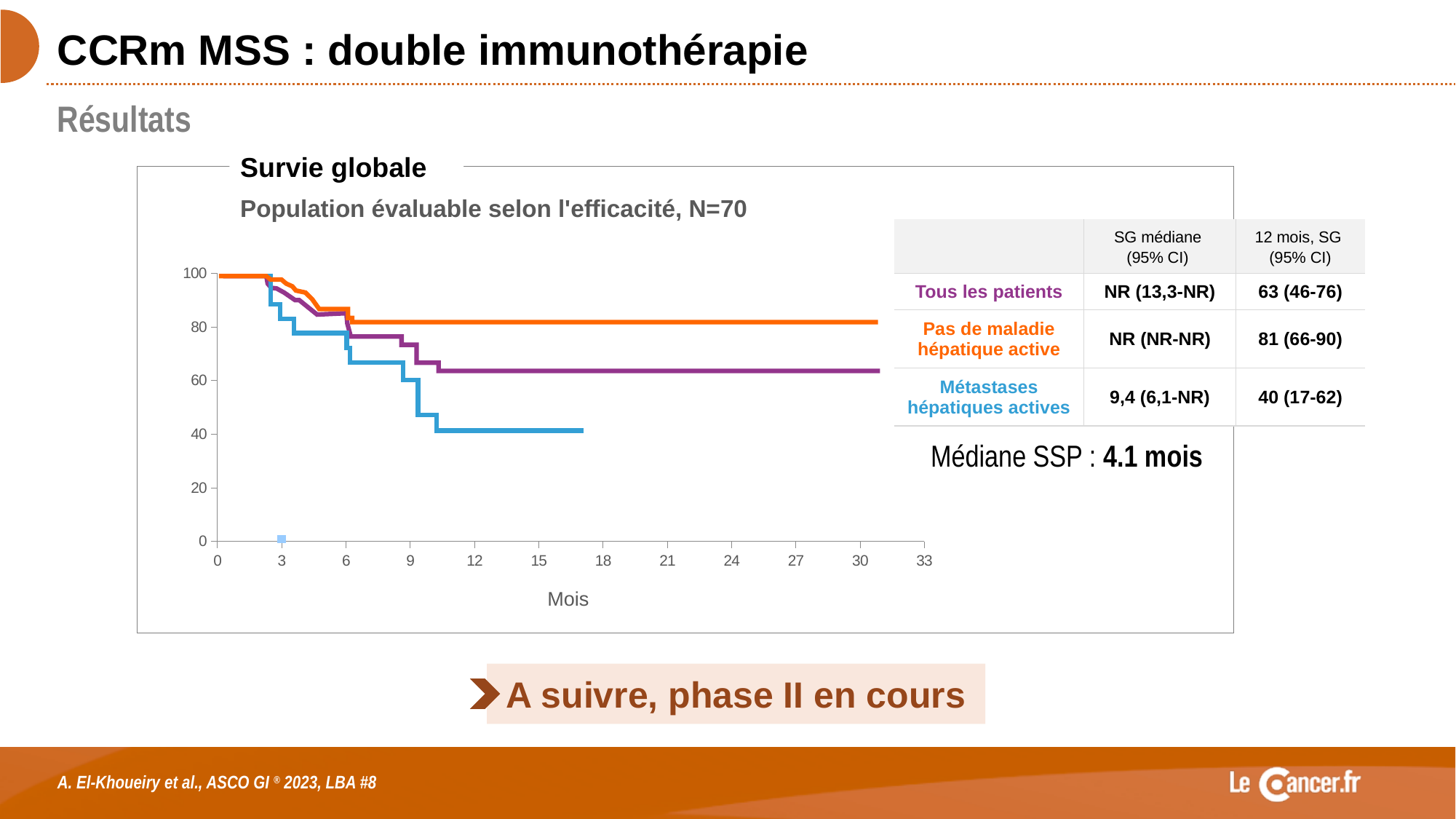
Is the value of the purple curve (Tous les patients) at 30 months greater or less than 60? greater What kind of chart is shown on the slide? line chart At 15 months, which curve is higher: the orange curve or the blue curve? the orange curve What is the label of the x axis of the chart? Mois Is the value of the orange curve (Pas de maladie hépatique active) at 24 months greater or less than 60? greater Which curve is the lowest at 12 months? the blue curve (Métastases hépatiques actives) According to the table next to the chart, what is the 12-month overall survival (12 mois, SG) for patients with active liver metastases? 40 (17-62) How many survival curves are plotted on the chart? 3 Do the survival curves rise or fall as the number of months increases? fall Is the value of the blue curve (Métastases hépatiques actives) at 15 months greater or less than 60? less What is the title of the chart? Survie globale What is the highest tick value shown on the x axis of the chart? 33